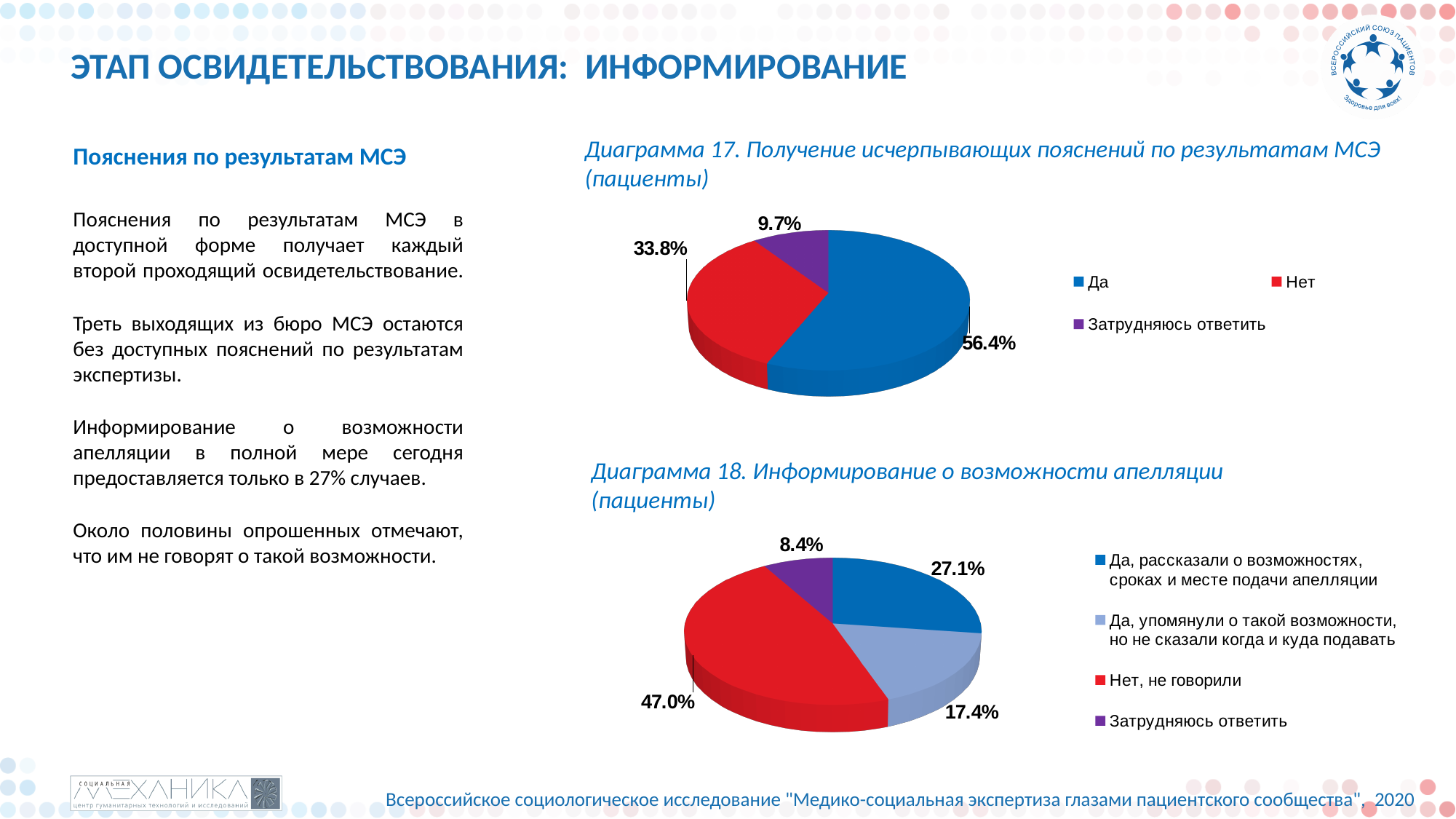
In Diagram 17, what share of patients answered "Нет"? 33.8% In Diagram 17 (Получение исчерпывающих пояснений по результатам МСЭ), what share of patients answered "Да"? 56.4% In Diagram 18, what colour is the slice for "Нет, не говорили"? Red In Diagram 17, which answer has the smallest share? Затрудняюсь ответить In Diagram 18, which is larger: the share for "Да, рассказали о возможностях, сроках и месте подачи апелляции" or for "Затрудняюсь ответить"? Да, рассказали о возможностях, сроках и месте подачи апелляции In Diagram 18, which answer has the largest share? Нет, не говорили In Diagram 18, how many slices does the pie have? 4 In Diagram 18 (Информирование о возможности апелляции), what share of patients answered "Нет, не говорили"? 47.0% What type of chart is Diagram 17? Pie chart In Diagram 17, how many answer categories does the legend list? 3 In Diagram 17, what is the difference between the "Да" and "Нет" shares? 22.6% In Diagram 18, what share of patients answered "Да, упомянули о такой возможности, но не сказали когда и куда подавать"? 17.4%